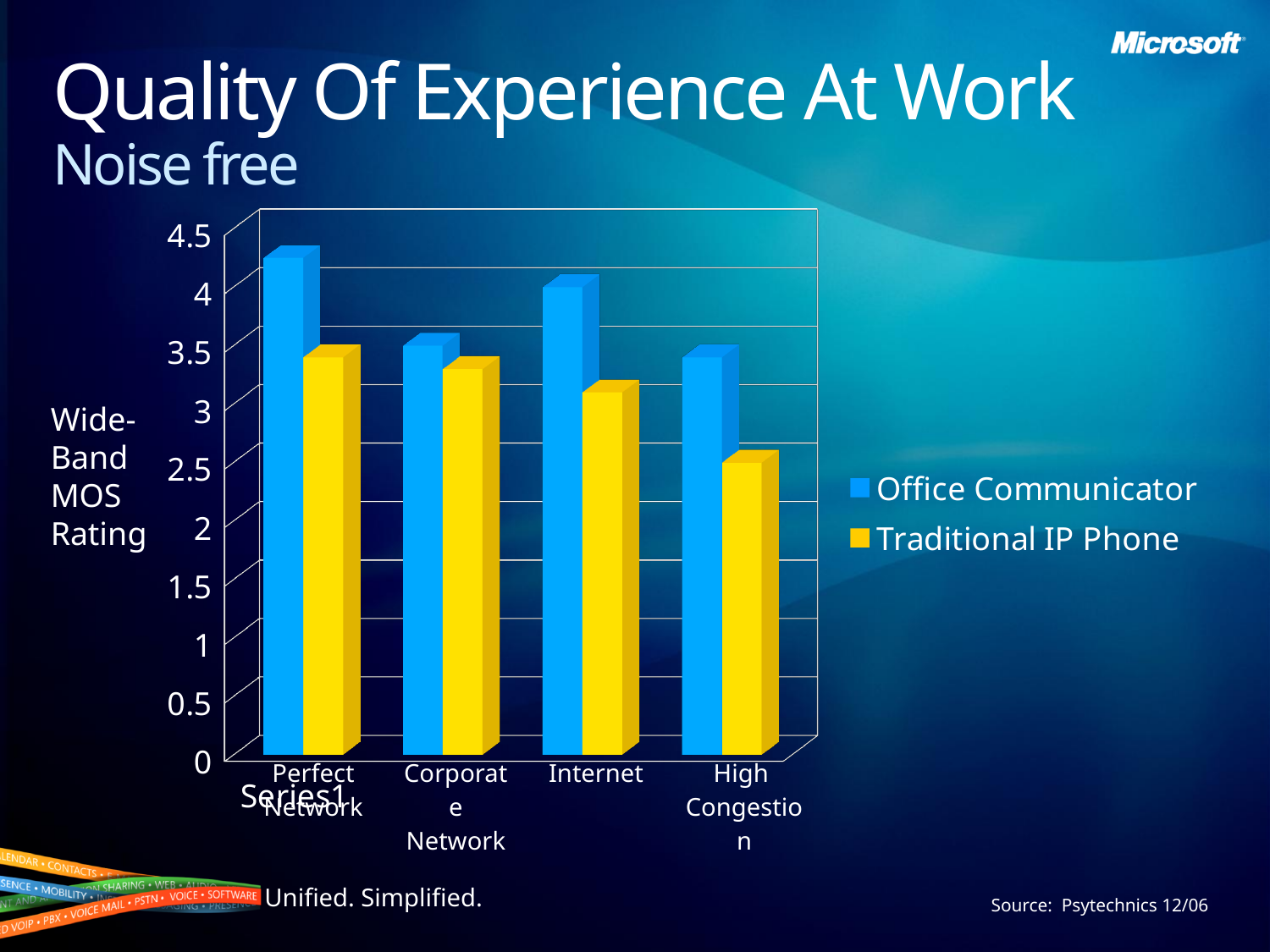
Which series is shown in blue in the legend? Office Communicator For which category is the Traditional IP Phone value lowest? High Congestion Is the Office Communicator value for Perfect Network greater or less than 4? greater Do the Traditional IP Phone values rise or fall from Perfect Network to High Congestion? fall How many categories are shown on the x axis? 4 Is the Traditional IP Phone value for High Congestion greater or less than 3? less What is the label on the vertical axis of the chart? Wide-Band MOS Rating What kind of chart is shown on the slide? bar chart For High Congestion, which is larger: Office Communicator or Traditional IP Phone? Office Communicator For which category is the Office Communicator value highest? Perfect Network Is the Office Communicator value for Corporate Network greater or less than 3? greater How many series does the legend list? 2